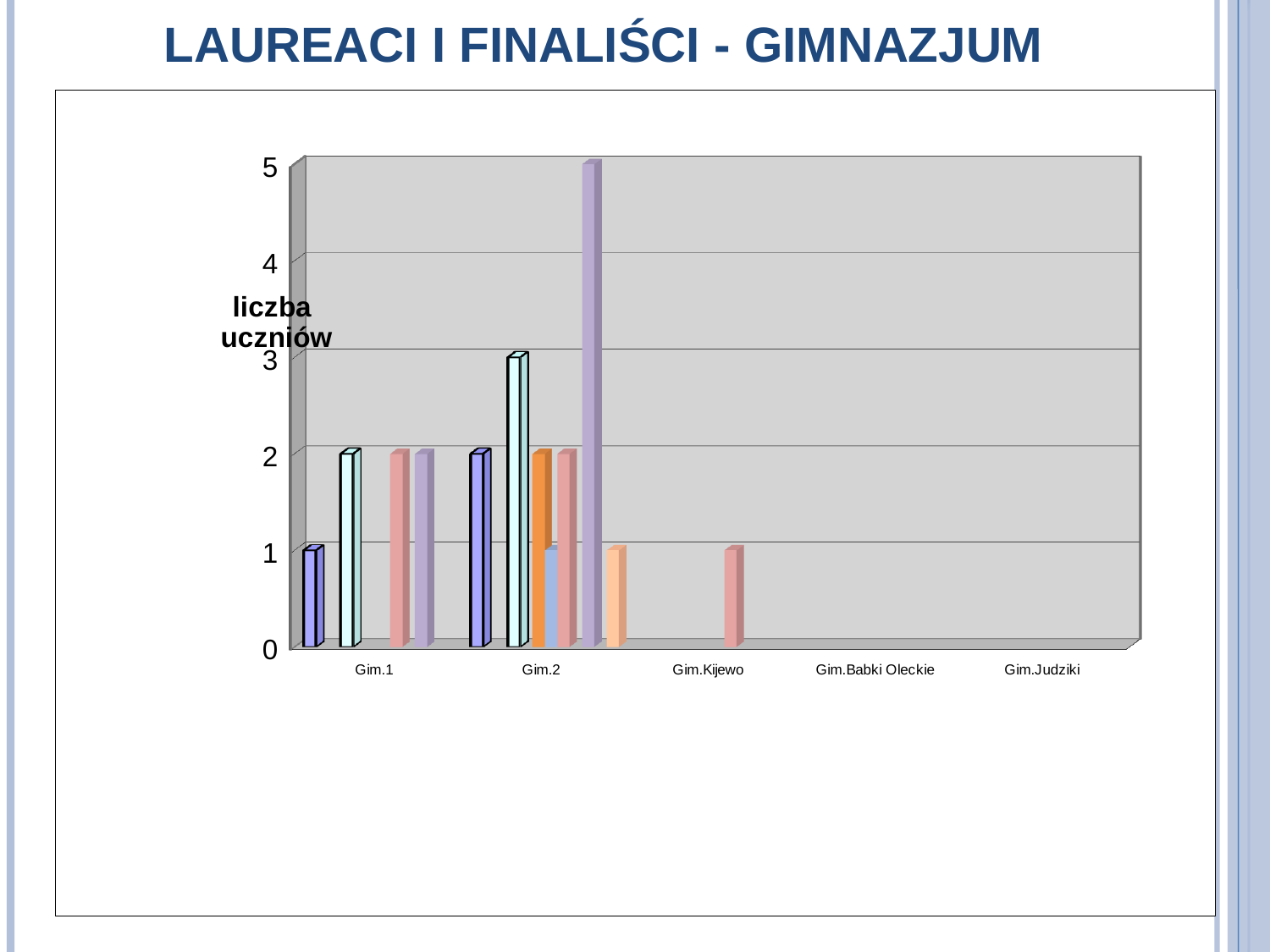
How many bars are shown for Gim.Babki Oleckie? 0 What is the label on the vertical axis of the chart? liczba uczniów Which is larger: the tallest bar for Gim.2 or the tallest bar for Gim.1? Gim.2 What is the title of the slide above the chart? LAUREACI I FINALIŚCI - GIMNAZJUM Which category contains the tallest bar in the chart? Gim.2 Is the tallest bar for Gim.2 greater or less than 4? greater What is the value of the tallest bar in the Gim.1 category? 2 How many categories are shown on the x axis of the chart? 5 What kind of chart is shown on the slide? bar chart What is the value of the only bar shown for Gim.Kijewo? 1